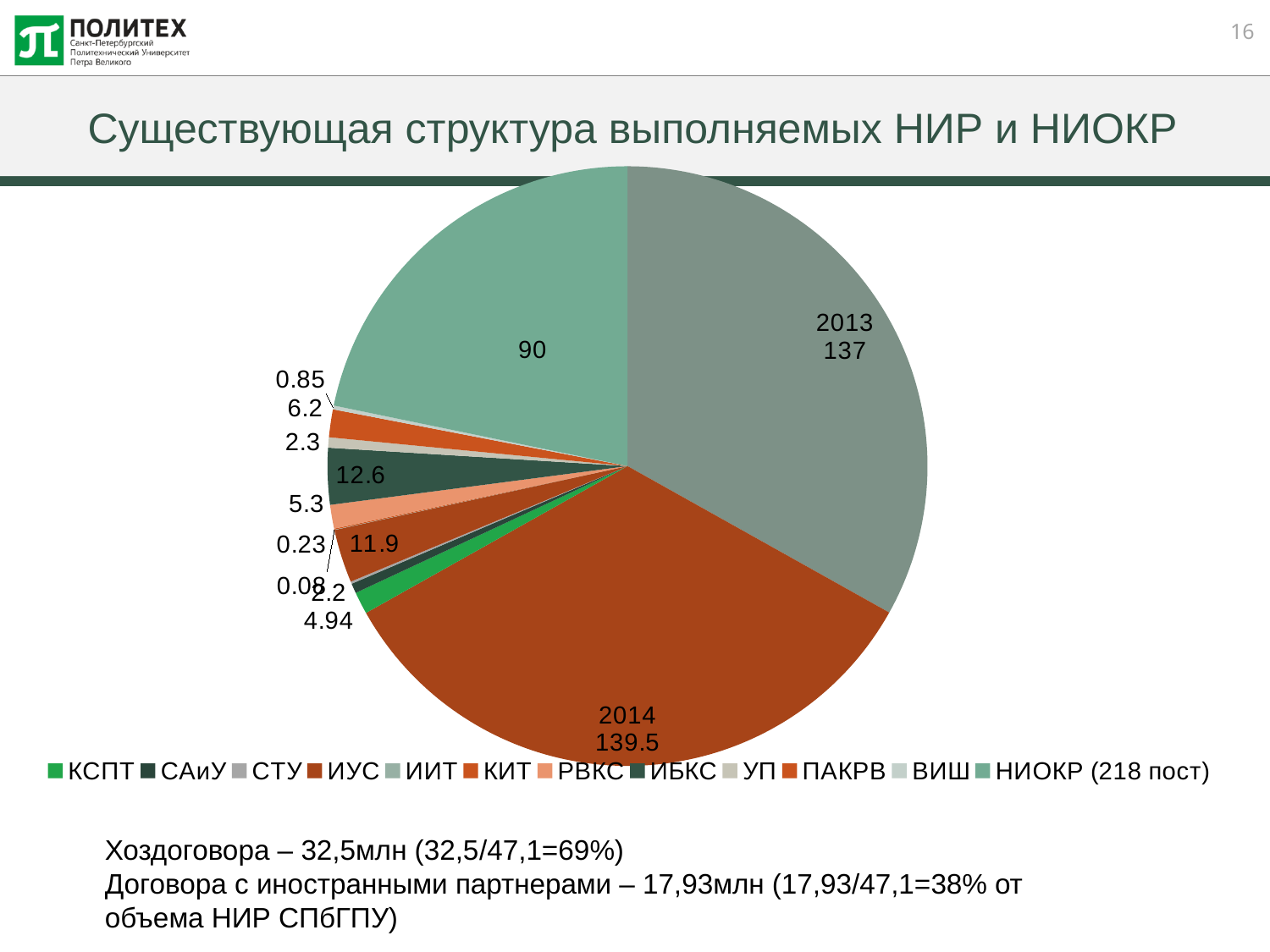
What kind of chart is shown on the slide? pie chart What is the last entry in the legend of the pie chart? НИОКР (218 пост) Which is larger: the slice labelled 90 or the slice labelled 2013 (137)? 2013 (137) What value is printed on the slice labelled 2013? 137 What is the largest value printed on the pie chart? 139.5 Which is larger: the slice labelled 12.6 or the slice labelled 11.9? 12.6 What is the smallest value printed on the pie chart? 0.08 What is the difference between the values of the slices labelled 2014 and 2013? 2.5 How many entries does the legend of the pie chart list? 12 What value is printed on the slice labelled 2014? 139.5 What value is printed on the bright green КСПТ slice? 4.94 What is the title of the slide containing the pie chart? Существующая структура выполняемых НИР и НИОКР